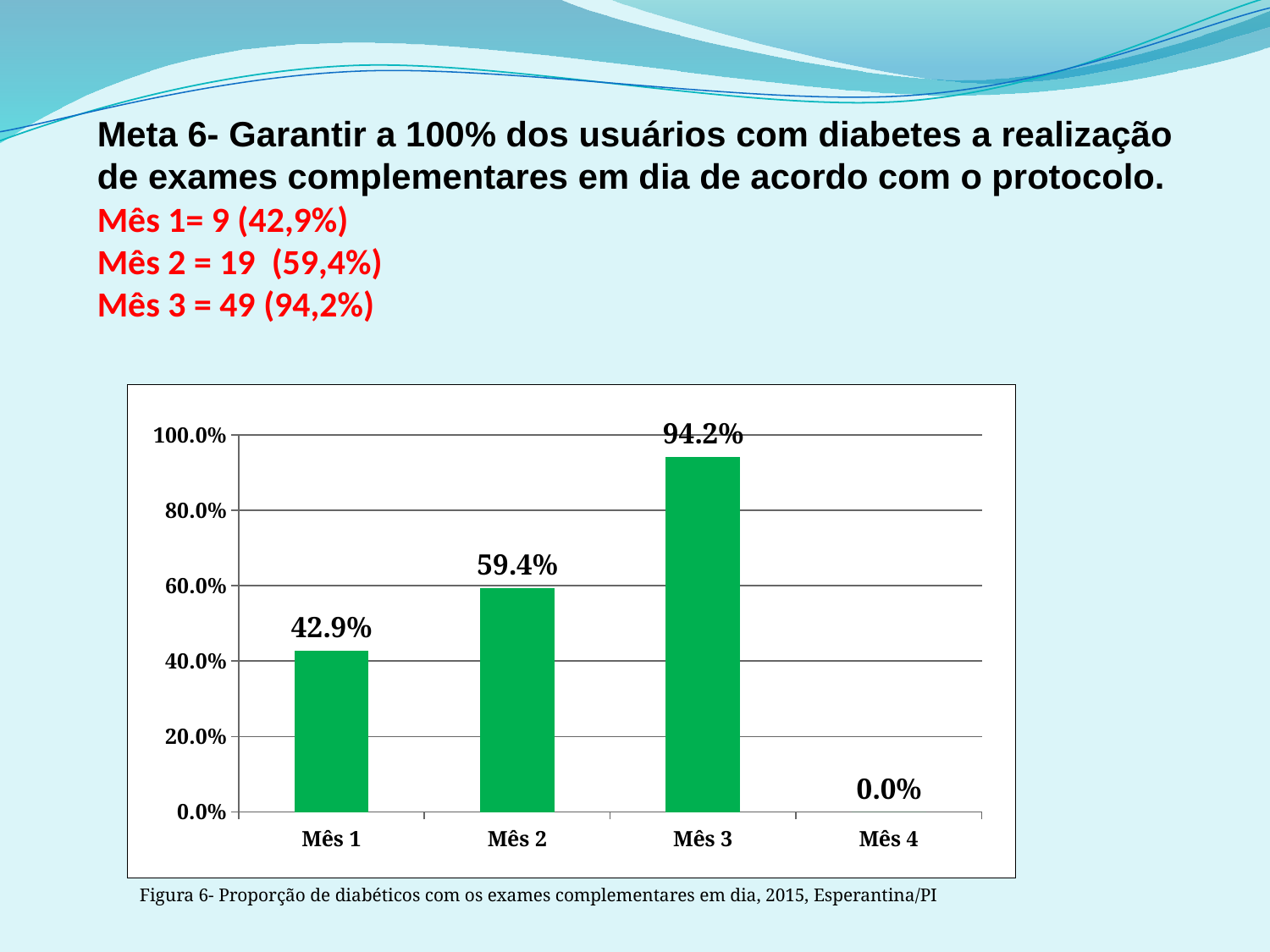
How many months are shown on the x axis? 4 Which month has the highest value? Mês 3 Is the value for Mês 3 greater or less than 80.0%? greater What is the value for Mês 4? 0.0% What kind of chart is shown? bar chart What is the caption of the figure below the chart? Figura 6- Proporção de diabéticos com os exames complementares em dia, 2015, Esperantina/PI What is the value for Mês 2? 59.4% Which month has the lowest value? Mês 4 What is the value for Mês 3? 94.2% What is the value for Mês 1? 42.9% What is the difference between the values for Mês 3 and Mês 2? 34.8% Which is larger, the value for Mês 1 or the value for Mês 2? Mês 2